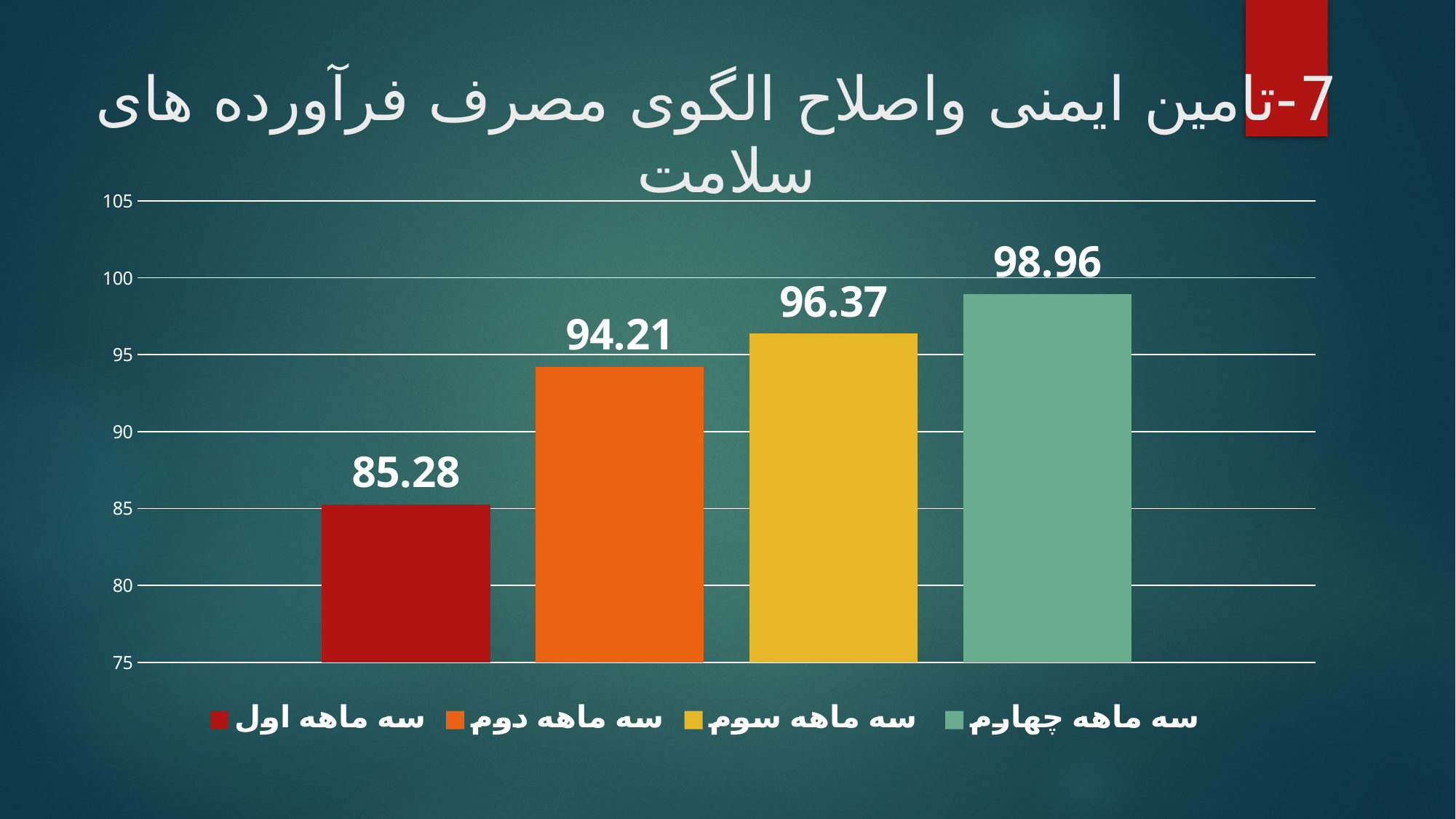
What is the value for سه ماهه دوم? 94.21 What is the value for سه ماهه اول? 85.28 Is the value for سه ماهه اول greater or less than 90? less How many bars are shown in the chart? 4 Do the values rise or fall from سه ماهه اول to سه ماهه چهارم? rise What is the difference between the values for سه ماهه چهارم and سه ماهه اول? 13.68 Which category has the highest value? سه ماهه چهارم What kind of chart is shown on the slide? bar chart Which category has the lowest value? سه ماهه اول What is the value for سه ماهه سوم? 96.37 Which is larger, the value for سه ماهه دوم or سه ماهه سوم? سه ماهه سوم What is the value for سه ماهه چهارم? 98.96